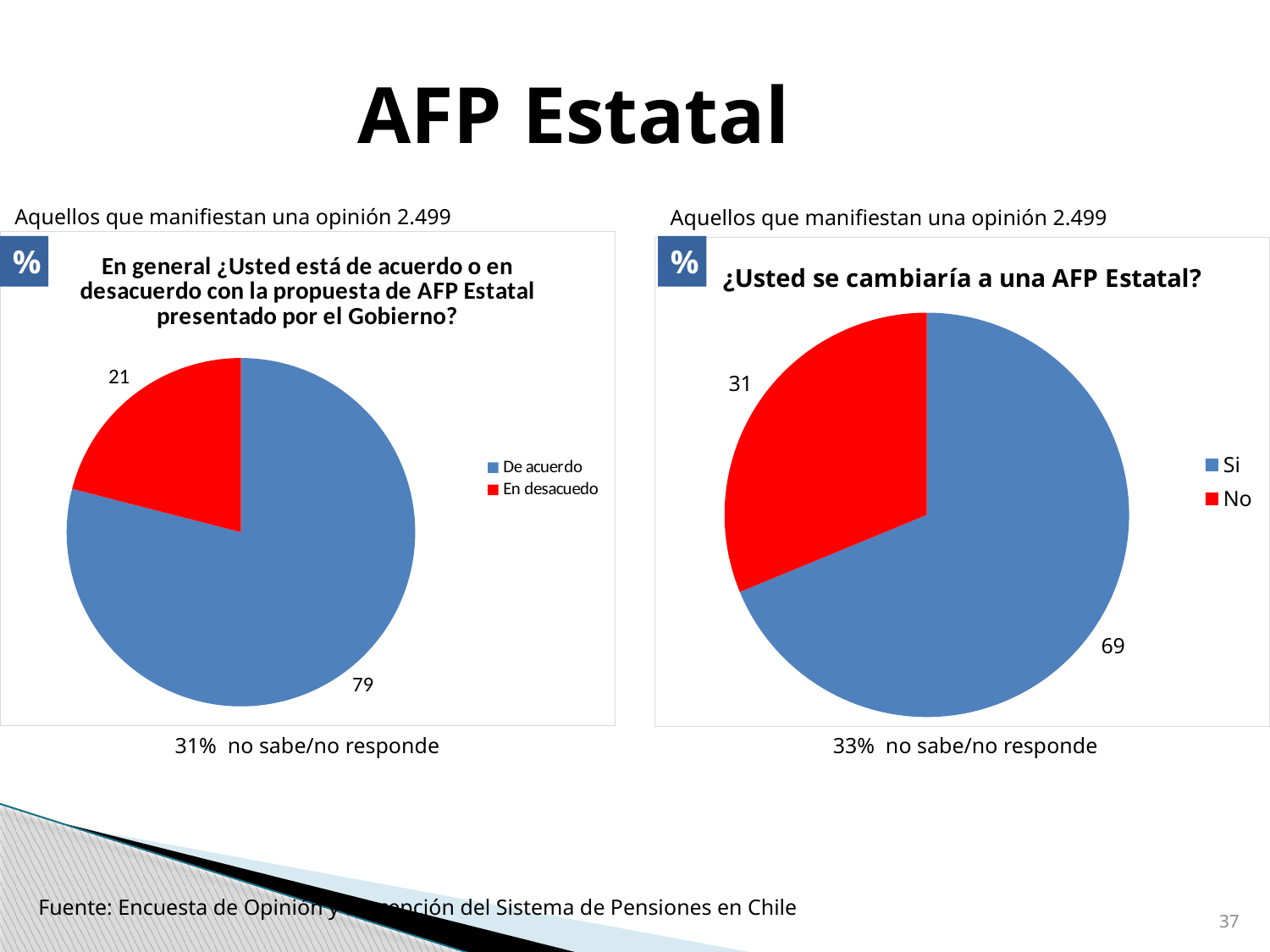
In the left chart (En general ¿Usted está de acuerdo o en desacuerdo...), what is the value for En desacuedo? 21 In the left chart (En general ¿Usted está de acuerdo o en desacuerdo...), which category has the largest slice? De acuerdo How many slices does the right chart (¿Usted se cambiaría a una AFP Estatal?) have? 2 What kind of chart is the left chart (En general ¿Usted está de acuerdo o en desacuerdo...)? Pie chart In the right chart (¿Usted se cambiaría a una AFP Estatal?), what is the value for No? 31 In the right chart (¿Usted se cambiaría a una AFP Estatal?), what is the difference between Si and No? 38 In the right chart (¿Usted se cambiaría a una AFP Estatal?), which category has the smallest slice? No In the right chart (¿Usted se cambiaría a una AFP Estatal?), what colour is the Si slice? Blue In the left chart (En general ¿Usted está de acuerdo o en desacuerdo con la propuesta de AFP Estatal presentado por el Gobierno?), what is the value for De acuerdo? 79 In the left chart (En general ¿Usted está de acuerdo o en desacuerdo...), what is the difference between De acuerdo and En desacuedo? 58 In the right chart (¿Usted se cambiaría a una AFP Estatal?), which is larger, Si or No? Si In the right chart (¿Usted se cambiaría a una AFP Estatal?), what is the value for Si? 69